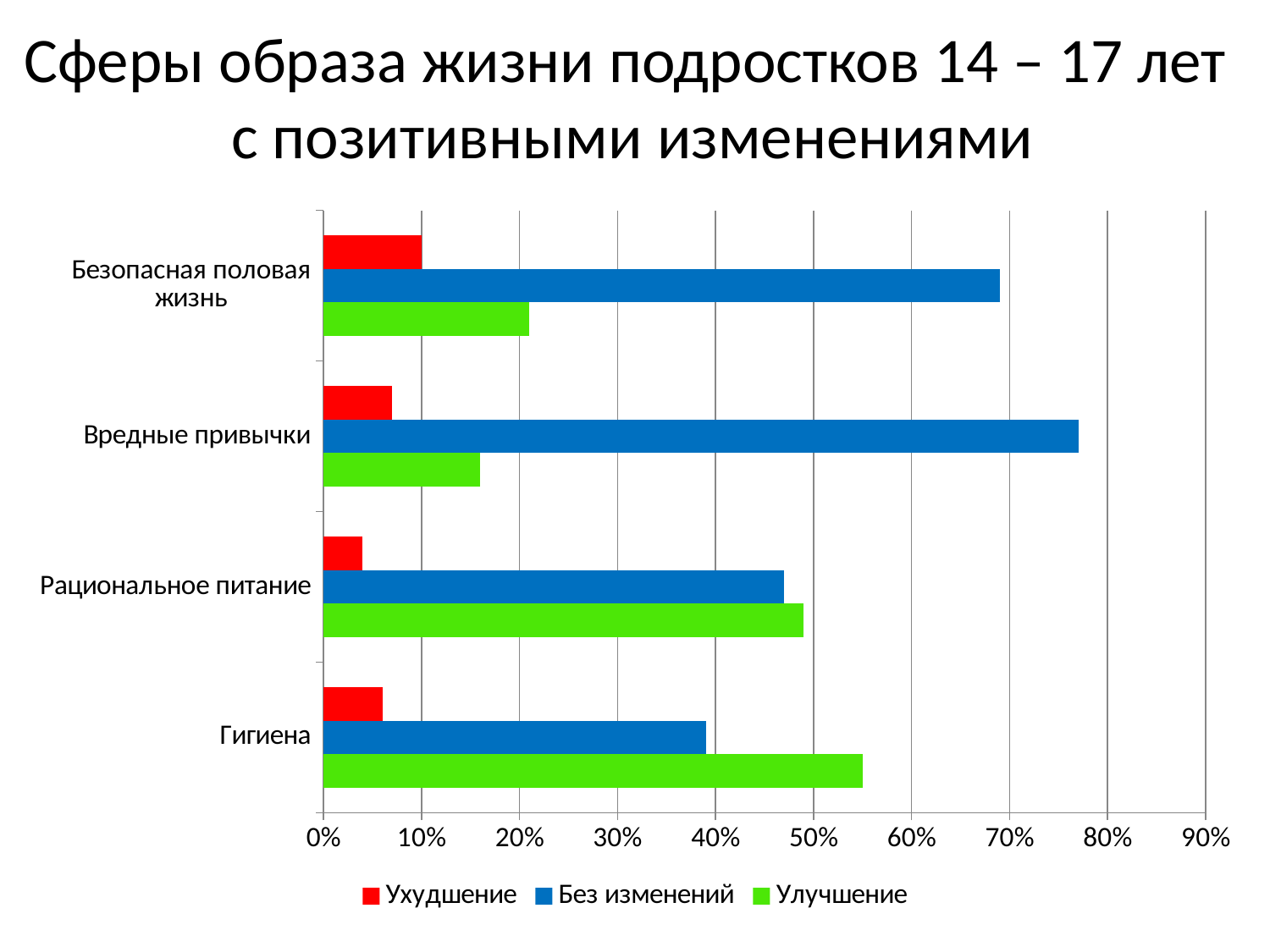
Which category has the highest value for Без изменений? Вредные привычки Which category has the highest value for Улучшение? Гигиена Is the value for Улучшение in Гигиена greater or less than 50%? greater How many categories are shown on the vertical axis? 4 Is the value for Без изменений in Гигиена greater or less than 50%? less Which category has the lowest value for Ухудшение? Рациональное питание How many series does the legend list? 3 For Гигиена, which is larger: Улучшение or Без изменений? Улучшение What kind of chart is shown on the slide? Bar chart Is the value for Улучшение in Безопасная половая жизнь greater or less than 30%? less What are the three series named in the legend? Ухудшение, Без изменений, Улучшение